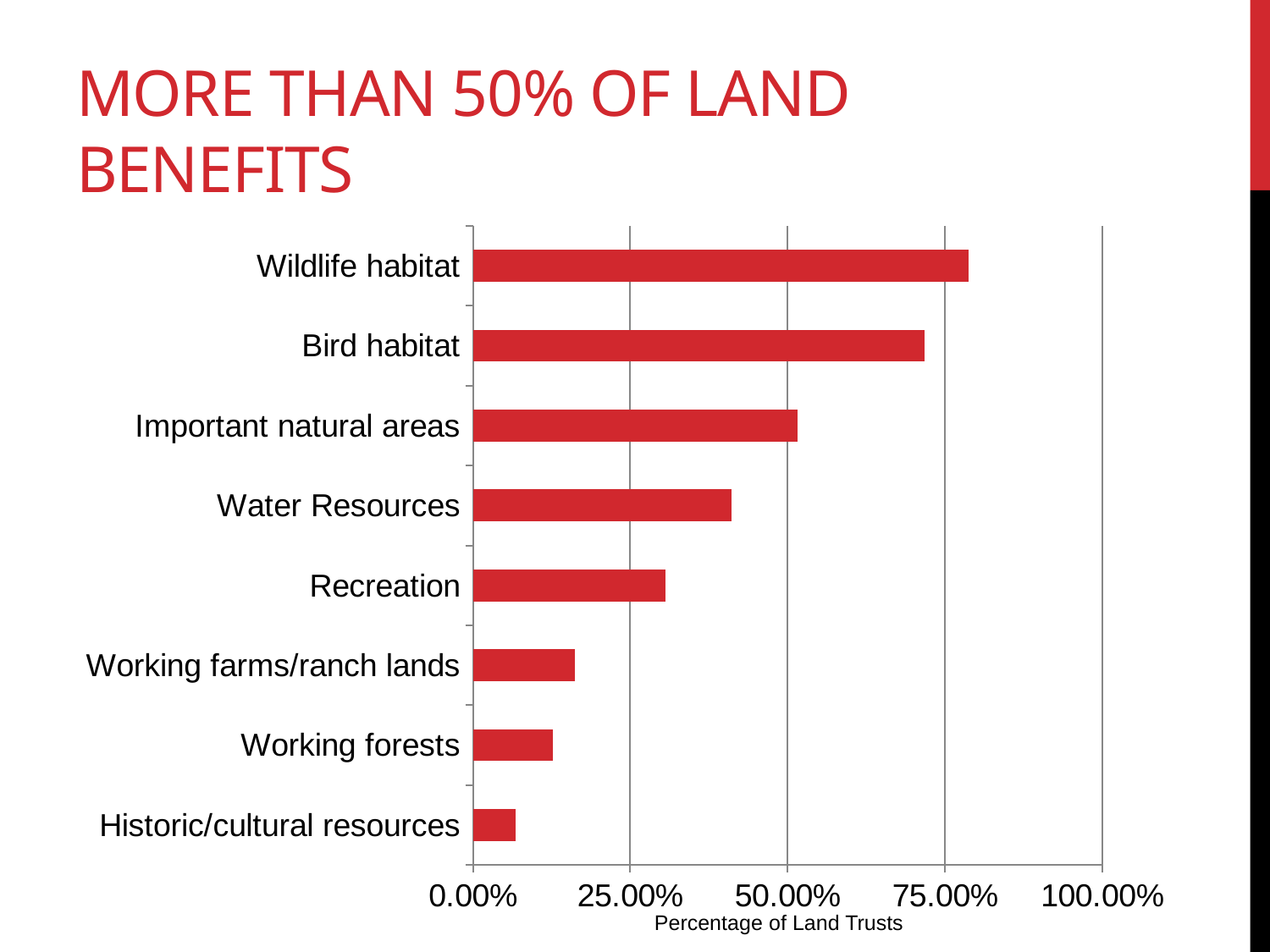
Is the value for Bird habitat greater or less than 75.00%? less Is the value for Water Resources greater or less than 50.00%? less Which is larger, the value for Working forests or the value for Recreation? Recreation Is the value for Working farms/ranch lands greater or less than 25.00%? less What kind of chart is shown on the slide? Bar chart Which is larger, the value for Bird habitat or the value for Water Resources? Bird habitat What is the label on the horizontal axis of the chart? Percentage of Land Trusts Which category has the highest percentage of land trusts? Wildlife habitat How many categories are plotted in the chart? 8 Which category has the lowest percentage of land trusts? Historic/cultural resources